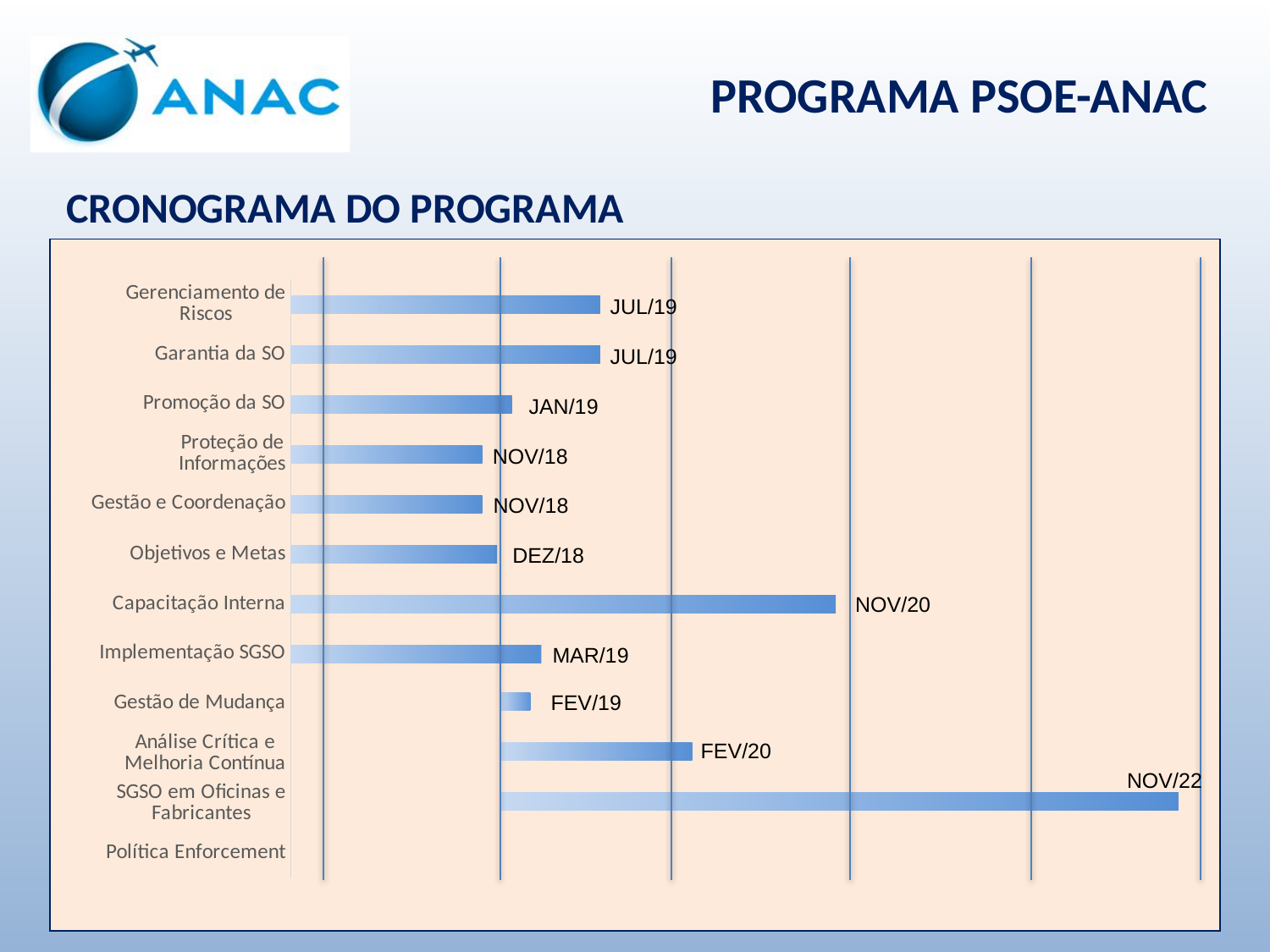
Which category has the bar that extends furthest to the right (latest end date)? SGSO em Oficinas e Fabricantes What date label is shown for the Gestão de Mudança bar? FEV/19 Which category on the vertical axis has no bar plotted? Política Enforcement What date label is shown for the Análise Crítica e Melhoria Contínua bar? FEV/20 Which bar extends further to the right: Capacitação Interna or Implementação SGSO? Capacitação Interna What date label is shown for the Capacitação Interna bar? NOV/20 What date label is shown for the SGSO em Oficinas e Fabricantes bar? NOV/22 What is the title shown above the chart? CRONOGRAMA DO PROGRAMA What date label is shown for the Implementação SGSO bar? MAR/19 What kind of chart is shown on the slide? bar chart What date label is shown for the Promoção da SO bar? JAN/19 How many categories are listed on the vertical axis of the chart? 12